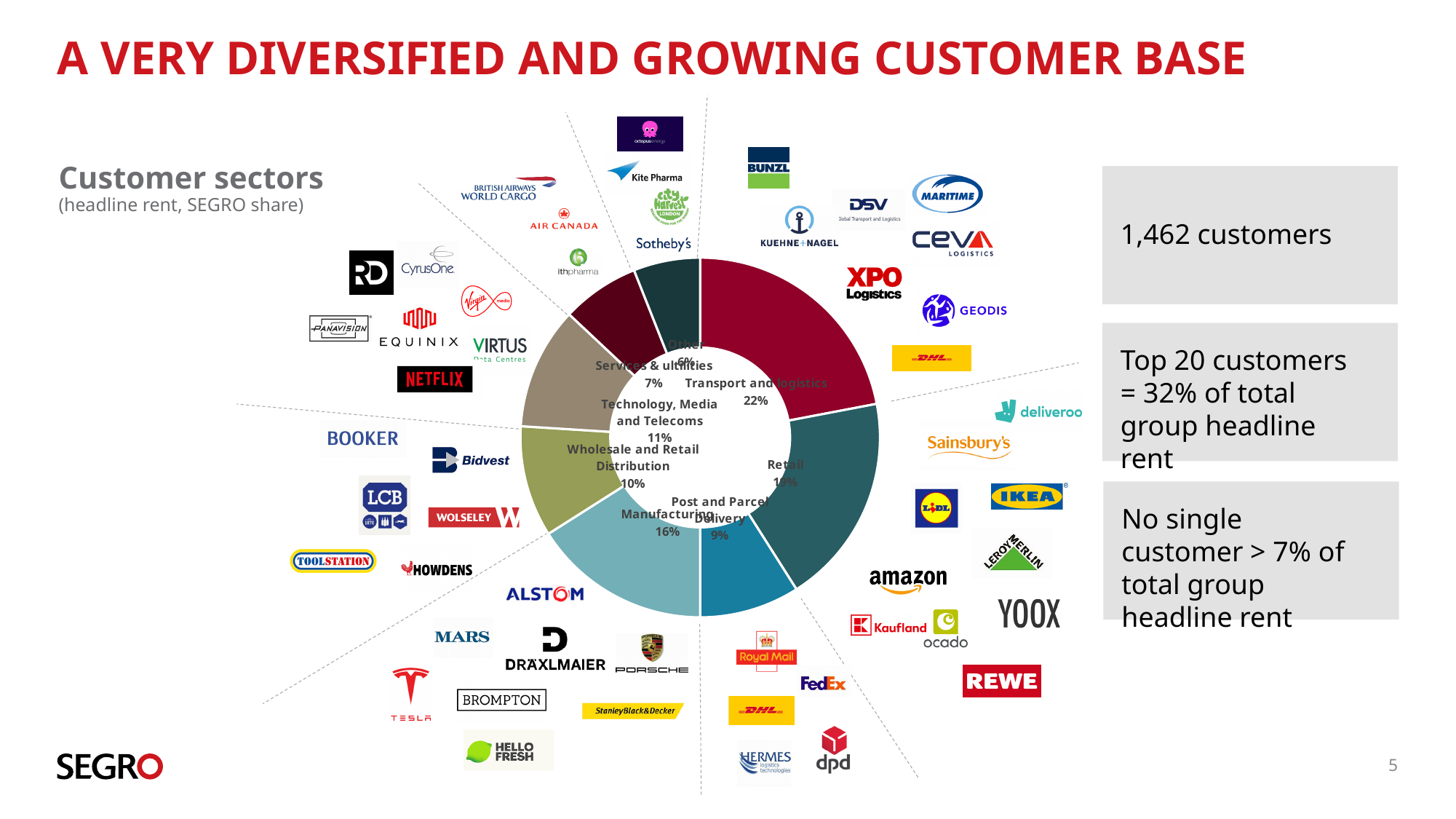
How many percentage points larger is Transport and logistics than Manufacturing? 6 percentage points What kind of chart is used to show the customer sectors? Doughnut (pie) chart What share is shown for Technology, Media and Telecoms? 11% What percentage is shown for Post and Parcel Delivery? 9% What share is labelled for the Other segment? 6% What percentage does the Services & utilities segment show? 7% What share of headline rent does the Transport and logistics sector account for? 22% Which segment of the customer sectors chart is the smallest? Other Which customer sector has the largest share of headline rent? Transport and logistics How many sector segments are shown in the customer sectors chart? 8 What is the value for Wholesale and Retail Distribution in the chart? 10% What is the value shown for Manufacturing in the customer sectors chart? 16%